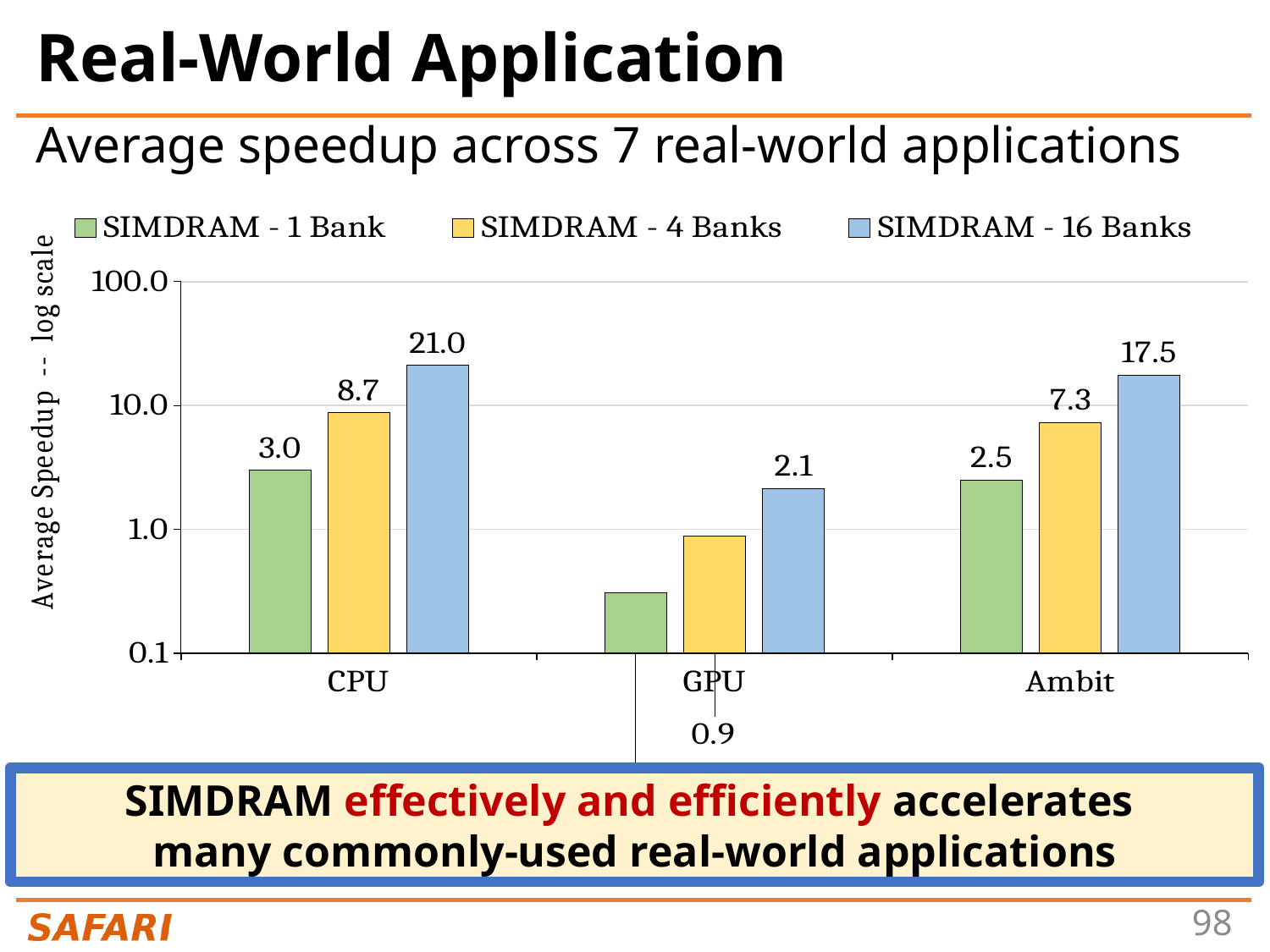
Which baseline category has the lowest SIMDRAM - 4 Banks speedup? GPU How many baseline categories are shown on the x axis? 3 What is the average speedup of SIMDRAM - 16 Banks for CPU? 21.0 Which is larger: the SIMDRAM - 1 Bank speedup for CPU or for Ambit? CPU What kind of chart is shown on the slide? bar chart Which baseline category has the highest SIMDRAM - 16 Banks speedup? CPU Is the SIMDRAM - 1 Bank speedup for GPU greater or less than 1.0? less What is the average speedup of SIMDRAM - 4 Banks for Ambit? 7.3 What is the difference between the SIMDRAM - 16 Banks speedup for CPU and for Ambit? 3.5 What is the average speedup of SIMDRAM - 1 Bank for CPU? 3.0 How many series does the legend list? 3 What is the average speedup of SIMDRAM - 4 Banks for GPU? 0.9